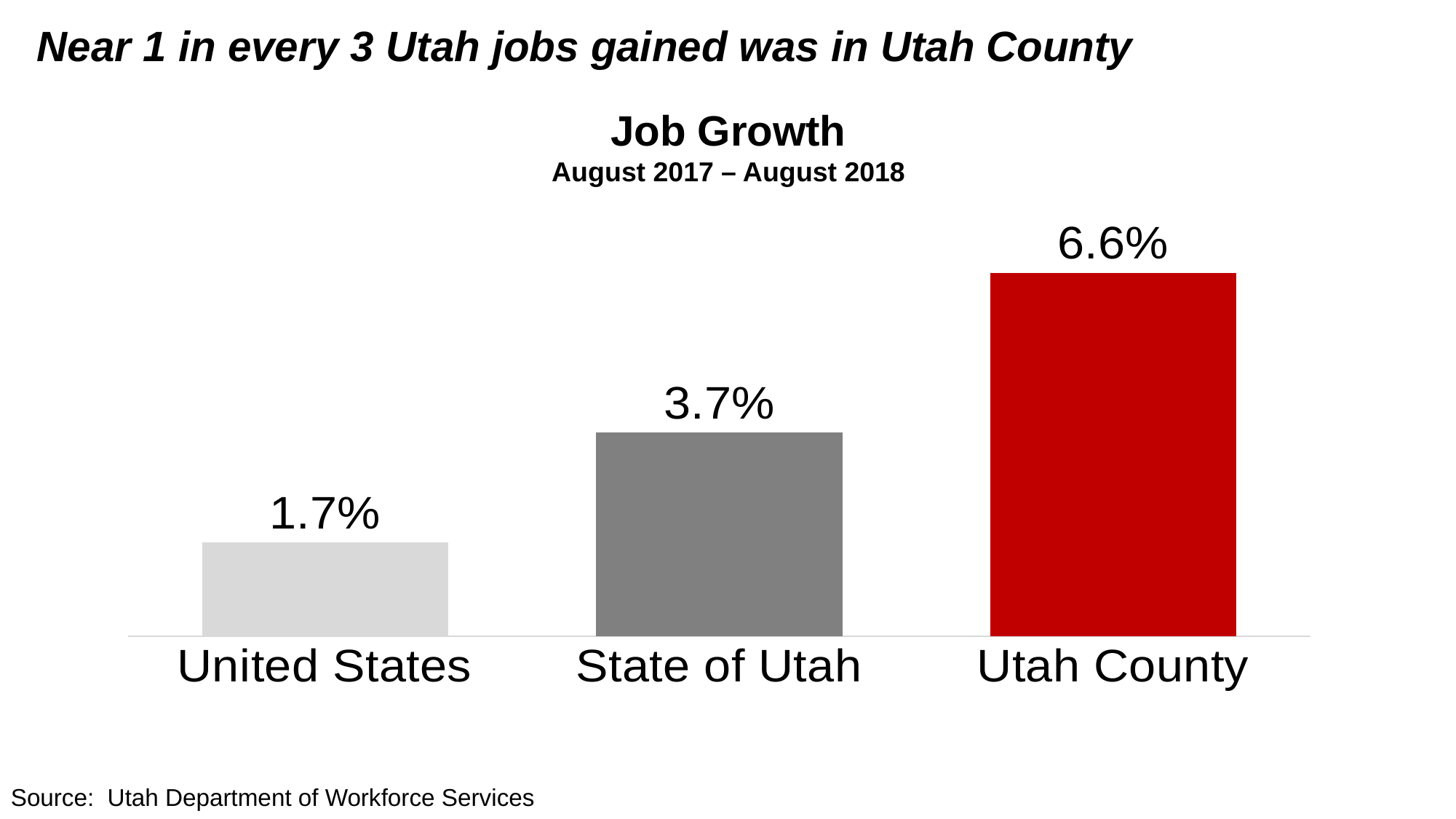
What is the job growth value for Utah County? 6.6% What is the job growth value for State of Utah? 3.7% What is the difference in job growth between State of Utah and United States? 2.0% What time period does the chart subtitle cover? August 2017 – August 2018 Which has higher job growth, State of Utah or United States? State of Utah Do the values rise or fall from left to right across the categories? Rise Which category has the highest job growth? Utah County What is the job growth value for United States? 1.7% Which category has the lowest job growth? United States How many categories are shown in the chart? 3 What is the difference in job growth between Utah County and State of Utah? 2.9% What kind of chart is shown on the slide? Bar chart